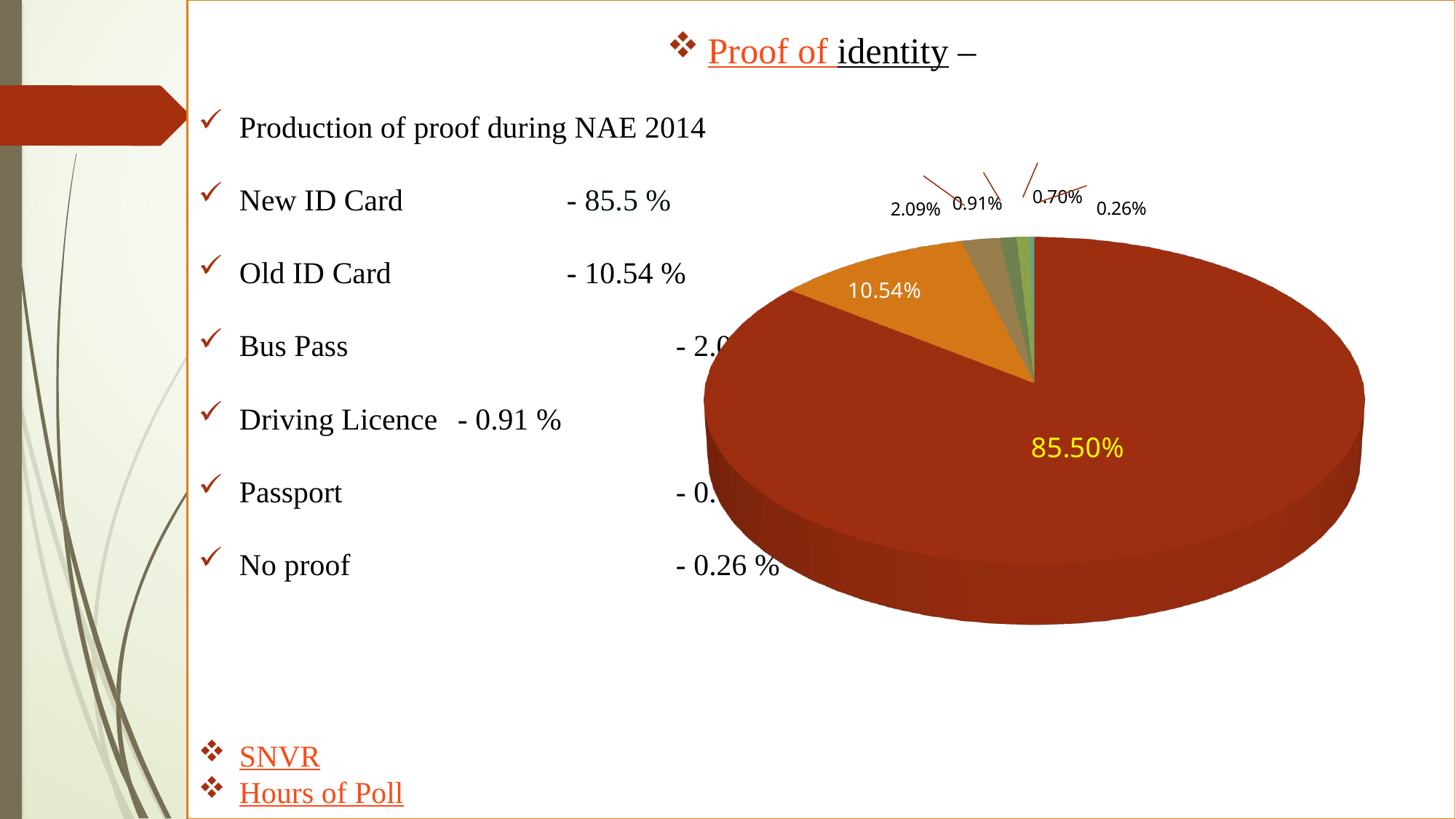
How many slices does the pie chart have? 6 According to the slide text, which category does the 0.26% slice of the pie chart represent? No proof According to the slide text, which category does the largest slice (85.50%) of the pie chart represent? New ID Card Which is larger in the pie chart: the slice labelled 0.70% or the slice labelled 0.91%? 0.91% What is the difference between the largest slice (85.50%) and the second largest slice (10.54%) in the pie chart? 74.96% What colour is the text of the 85.50% data label on the pie chart? yellow What is the difference between the 2.09% slice and the 0.91% slice in the pie chart? 1.18% What kind of chart is shown on the slide? pie chart What is the value shown on the smallest slice of the pie chart? 0.26% What is the value shown on the largest slice of the pie chart? 85.50% What is the value of the orange slice in the pie chart? 10.54% What share of the pie does the Old ID Card slice represent? 10.54%